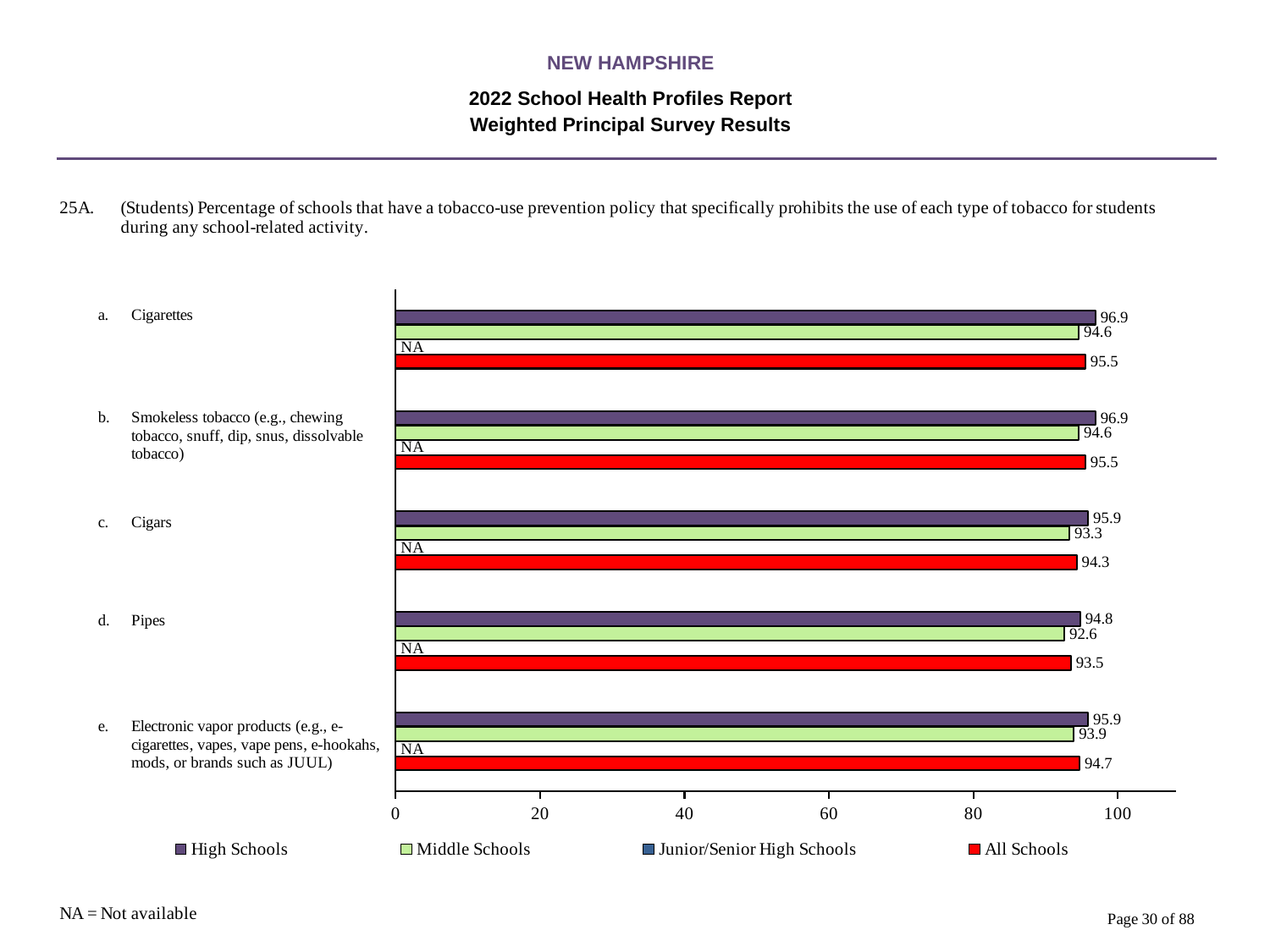
Which is larger for Pipes: the High Schools value or the All Schools value? High Schools What is the difference between the High Schools and Middle Schools values for Cigars? 2.6 Which category has the lowest value for All Schools? Pipes What kind of chart is shown on the slide? Bar chart How many tobacco product categories are shown on the chart? 5 Which series is shown in red in the legend? All Schools Which category has the highest value for Middle Schools? Cigarettes and Smokeless tobacco (both 94.6) How many series does the legend list? 4 What is the value for Junior/Senior High Schools for Cigars? NA What is the value for Middle Schools for Pipes? 92.6 What is the value for High Schools for Cigarettes? 96.9 What is the value for All Schools for Electronic vapor products? 94.7